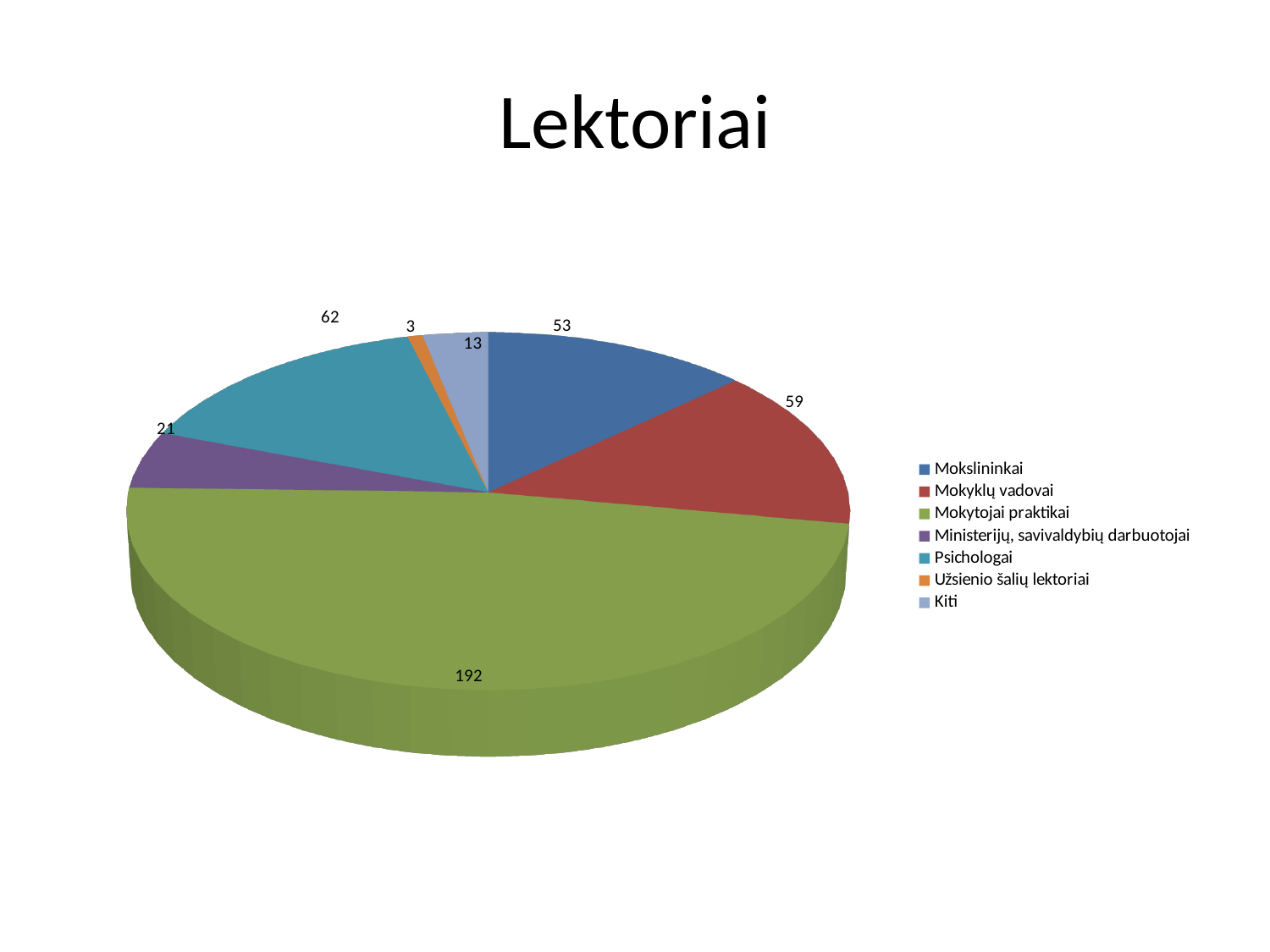
What is the difference between the values for Mokyklų vadovai and Mokslininkai? 6 What kind of chart is shown on the slide? pie chart What is the value for Mokytojai praktikai? 192 What is the value for Užsienio šalių lektoriai? 3 Which is larger, the value for Psichologai or the value for Kiti? Psichologai What is the title of the chart? Lektoriai What is the value for Ministerijų, savivaldybių darbuotojai? 21 Which category has the smallest slice? Užsienio šalių lektoriai Which category has the largest slice? Mokytojai praktikai What is the value for Psichologai? 62 How many categories does the legend list? 7 Which colour represents Mokslininkai in the chart? blue